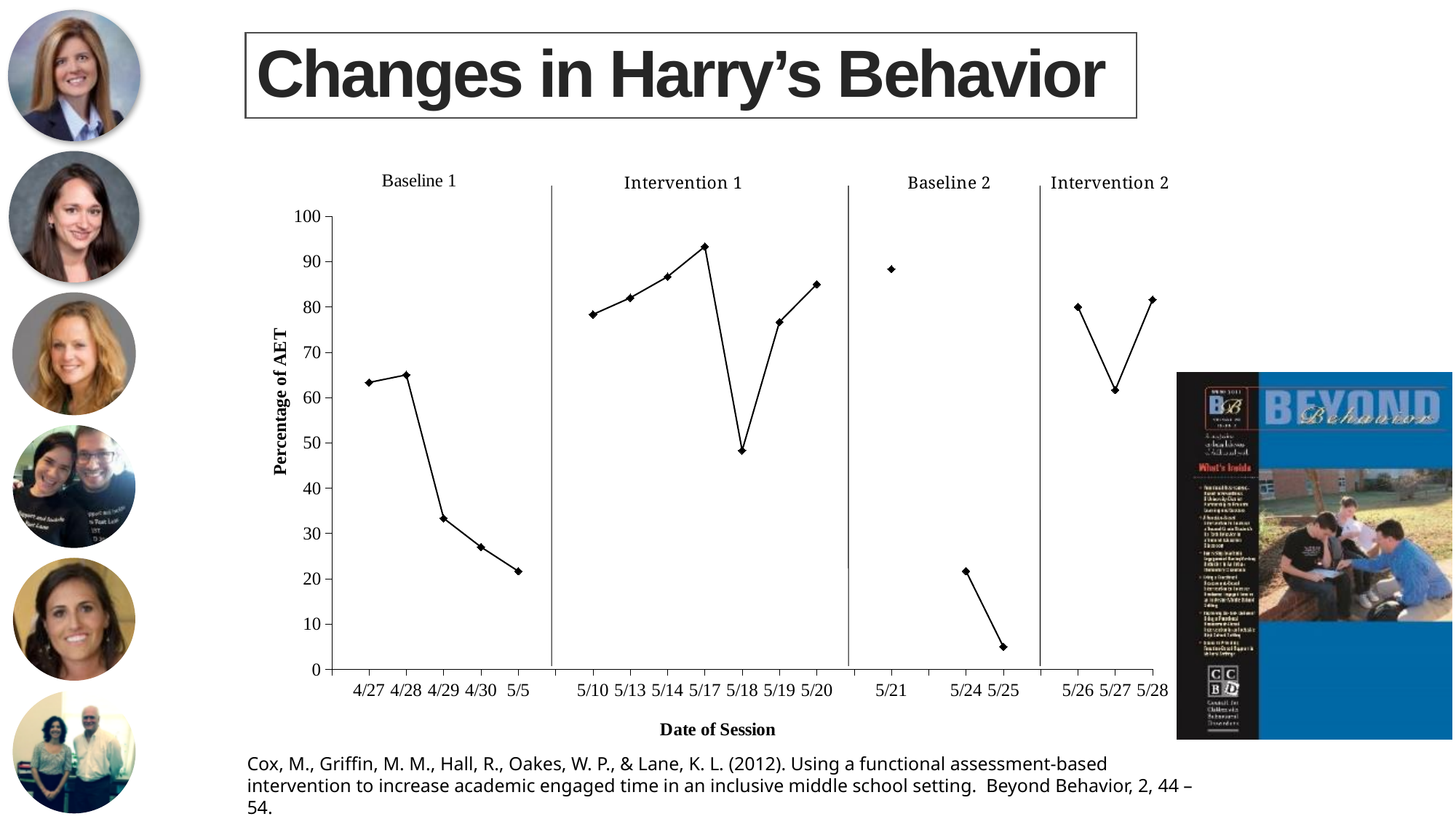
Is the value for 5/10 greater or less than 70? greater Which session date has the lowest percentage of AET? 5/25 Which session date has the highest percentage of AET? 5/17 Is the value for 5/27 greater or less than 70? less Is the value for 5/25 greater or less than 10? less What is the title of the y axis? Percentage of AET What are the four phase labels shown above the chart? Baseline 1, Intervention 1, Baseline 2, Intervention 2 Do the values rise or fall across the Baseline 1 sessions from 4/27 to 5/5? fall How many session dates are plotted on the x axis? 18 What kind of chart is shown on the slide? line chart Which has the higher percentage of AET, 5/17 or 5/18? 5/17